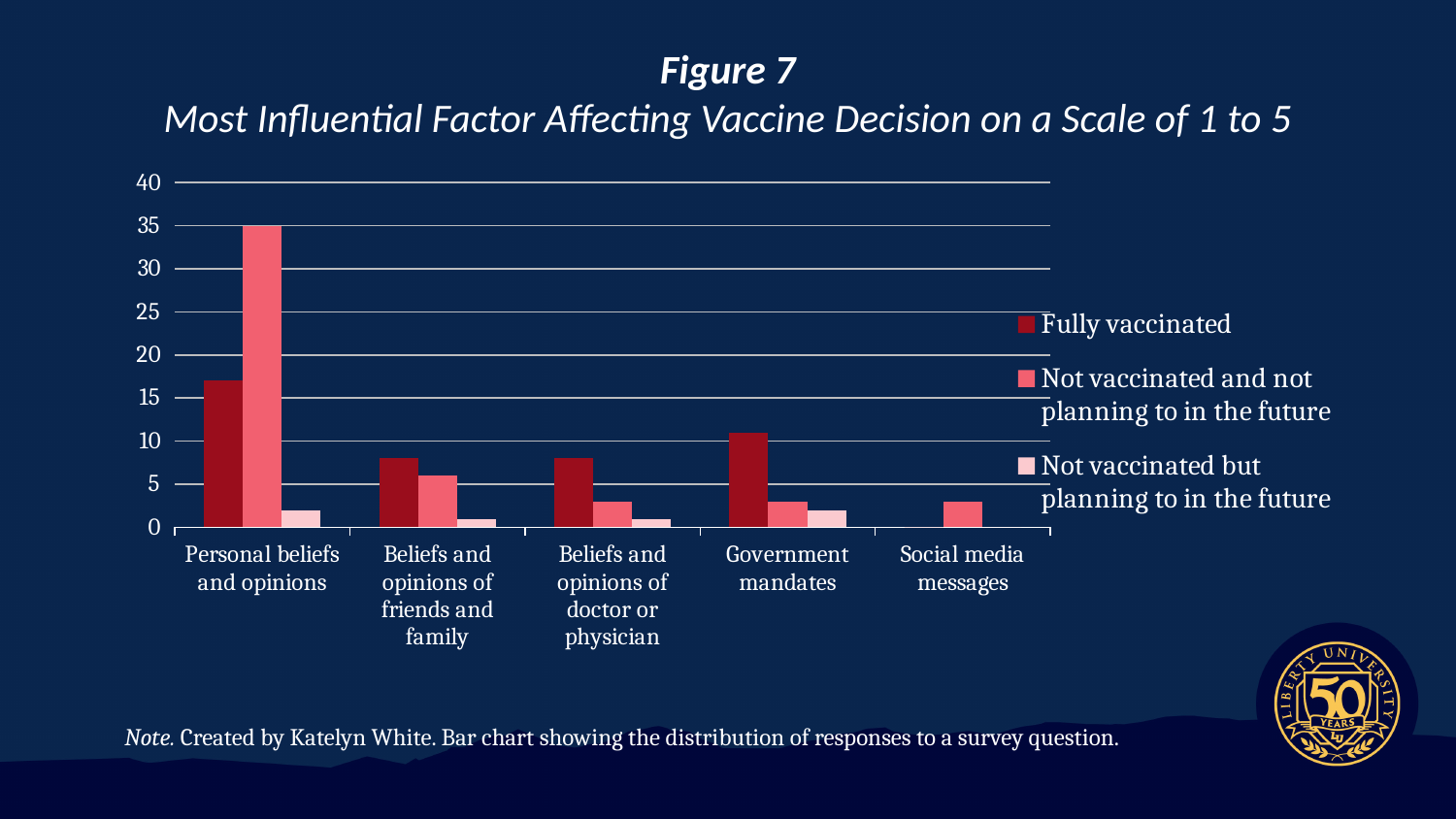
For Personal beliefs and opinions, which is larger: Fully vaccinated or Not vaccinated and not planning to in the future? Not vaccinated and not planning to in the future Is the value for Not vaccinated and not planning to in the future for Personal beliefs and opinions greater or less than 30? greater What kind of chart is shown on the slide? bar chart For Government mandates, which is larger: Fully vaccinated or Not vaccinated but planning to in the future? Fully vaccinated Is the value for Fully vaccinated for Government mandates greater or less than 10? greater Which category has the tallest bar overall? Personal beliefs and opinions Which category has the lowest value for the Fully vaccinated series? Social media messages Which category has the highest value for the Fully vaccinated series? Personal beliefs and opinions How many categories are shown on the x axis? 5 What is the title of the chart? Most Influential Factor Affecting Vaccine Decision on a Scale of 1 to 5 How many series does the legend list? 3 Is the value for Fully vaccinated for Personal beliefs and opinions greater or less than 20? less